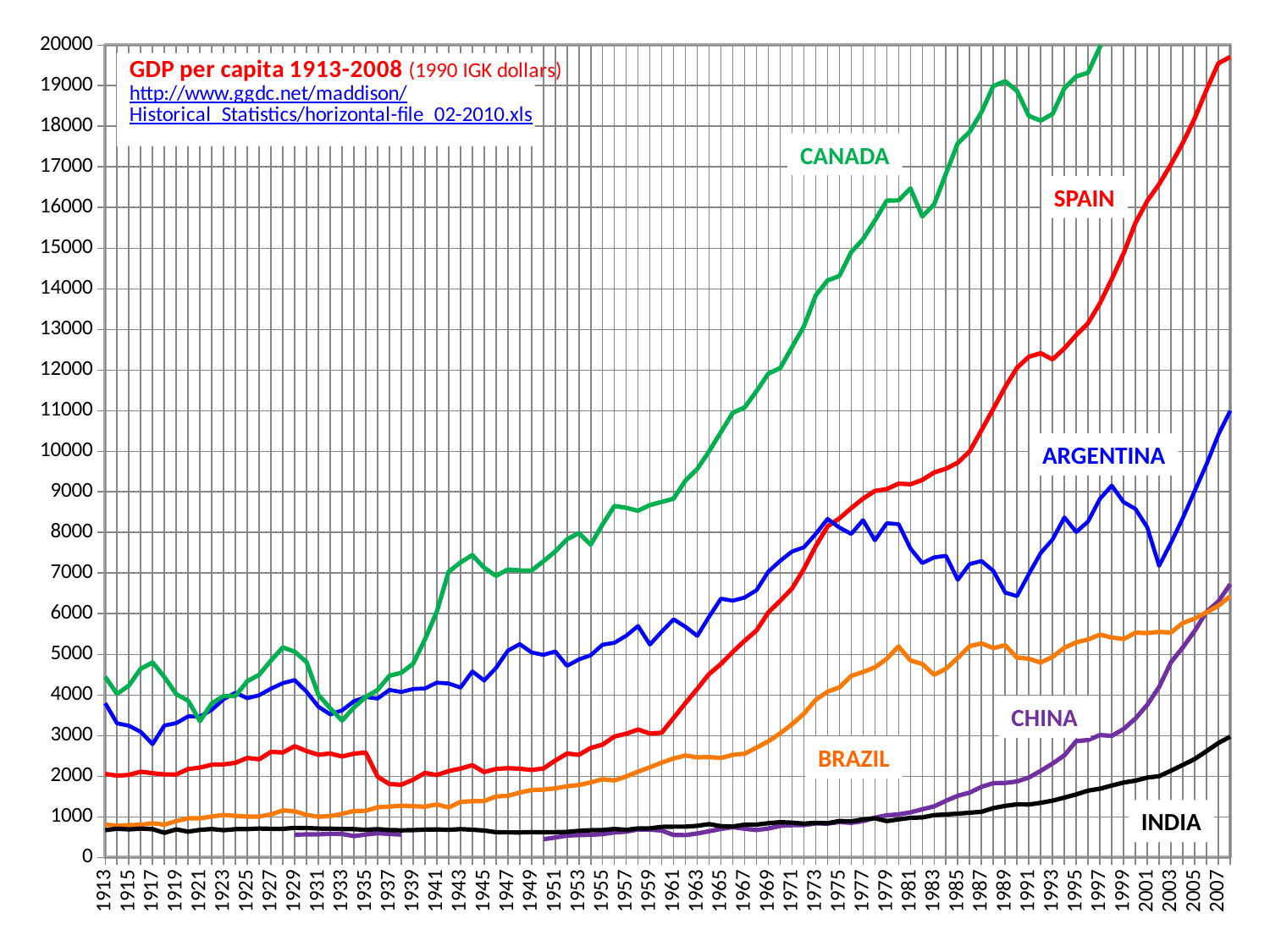
Is the value for India in 2007 greater or less than 5000? less How many countries are plotted on the chart? 6 Does the line for India generally rise or fall from 1913 to 2007? rise Which country has the highest GDP per capita in 1913? Canada Is the value for Spain in 1961 greater or less than 5000? less Which country has the lowest GDP per capita in 2007? India What colour is the line for Spain? red Is the value for Canada in 1913 greater or less than 5000? less In 1985, which is larger, the value for Spain or the value for Argentina? Spain What kind of chart is shown on the slide? line chart